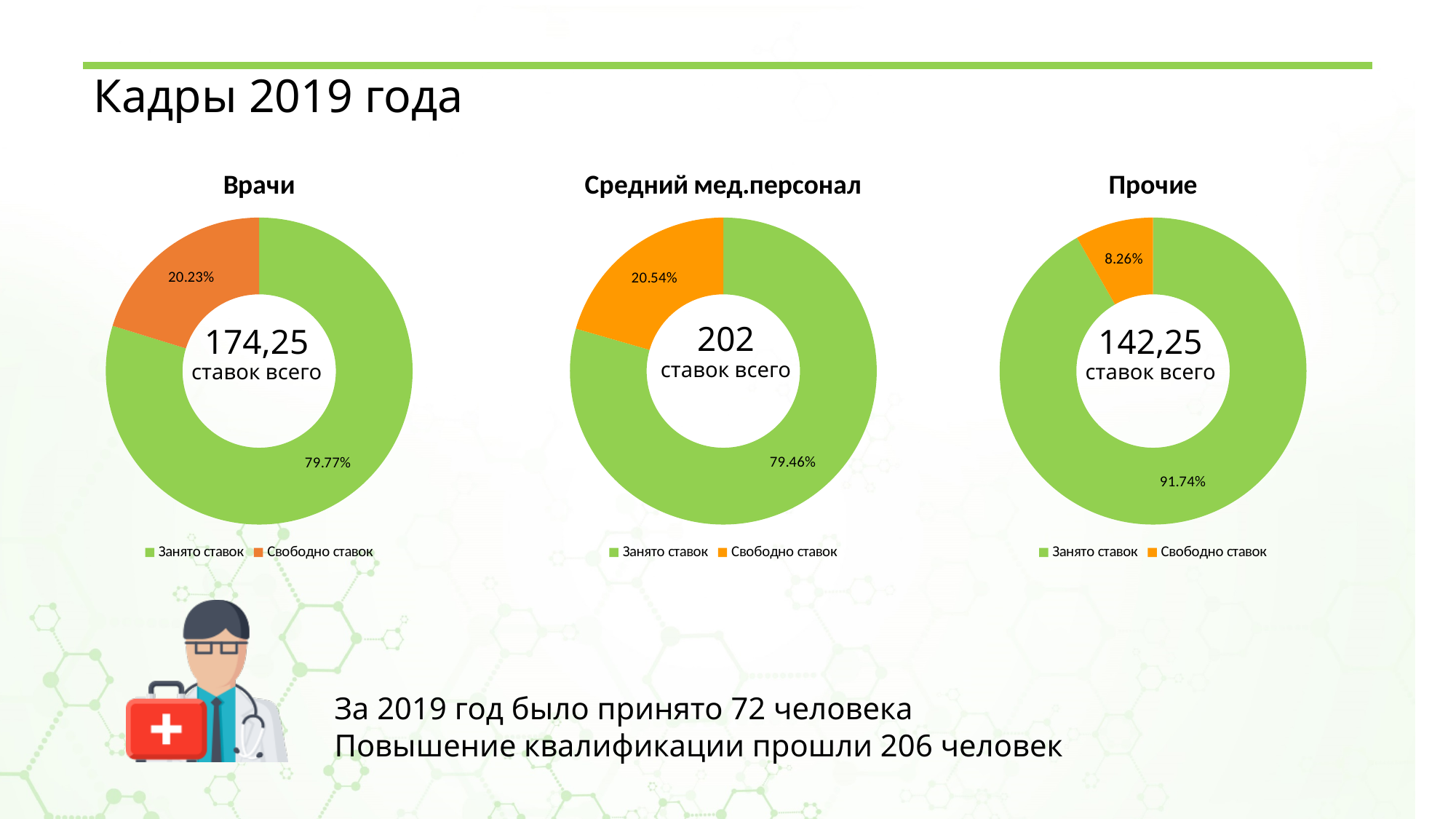
In the "Прочие" chart, what share is shown for "Занято ставок"? 91.74% What total number of positions is shown in the centre of the "Прочие" chart? 142,25 In the "Прочие" chart, what share is shown for "Свободно ставок"? 8.26% What kind of chart is used for "Врачи"? Donut (pie) chart Which of the three charts has the largest share for "Свободно ставок"? Средний мед.персонал In the "Врачи" chart, what share of positions is shown for "Свободно ставок"? 20.23% How many slices does the "Средний мед.персонал" chart have? 2 In the "Прочие" chart, which slice is larger: "Занято ставок" or "Свободно ставок"? Занято ставок What total number of positions is shown in the centre of the "Врачи" chart? 174,25 What total number of positions is shown in the centre of the "Средний мед.персонал" chart? 202